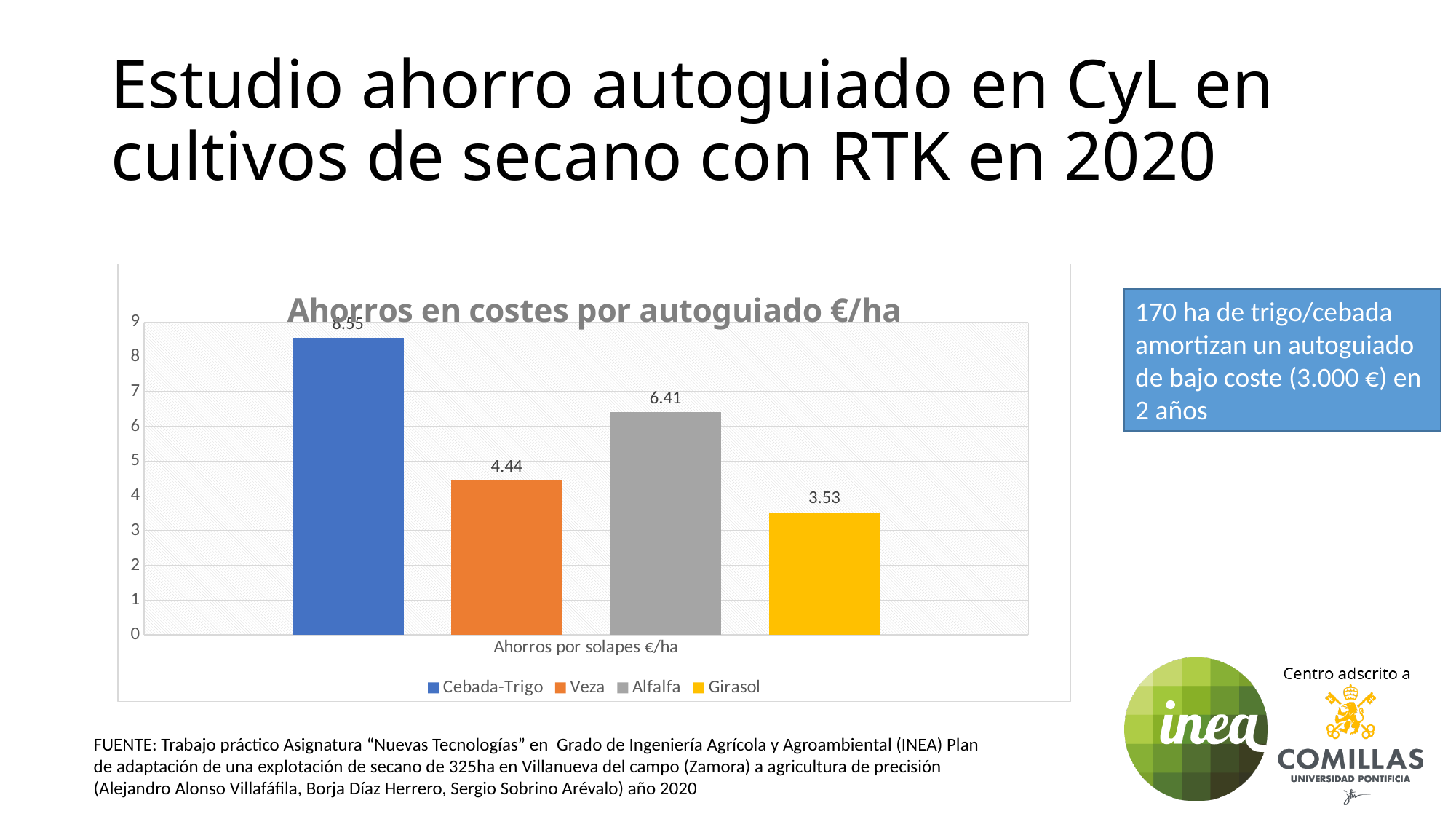
What kind of chart is shown? bar chart Is the value for Alfalfa greater or less than 6? greater What is the value for Girasol? 3.53 What is the value for Alfalfa? 6.41 Which crop has the highest savings? Cebada-Trigo How many series does the legend list? 4 What is the value for Veza? 4.44 What is the value for Cebada-Trigo? 8.55 Which is larger, the value for Alfalfa or the value for Veza? Alfalfa What is the title of the chart? Ahorros en costes por autoguiado €/ha Which crop has the lowest savings? Girasol What is the difference between the values for Cebada-Trigo and Girasol? 5.02